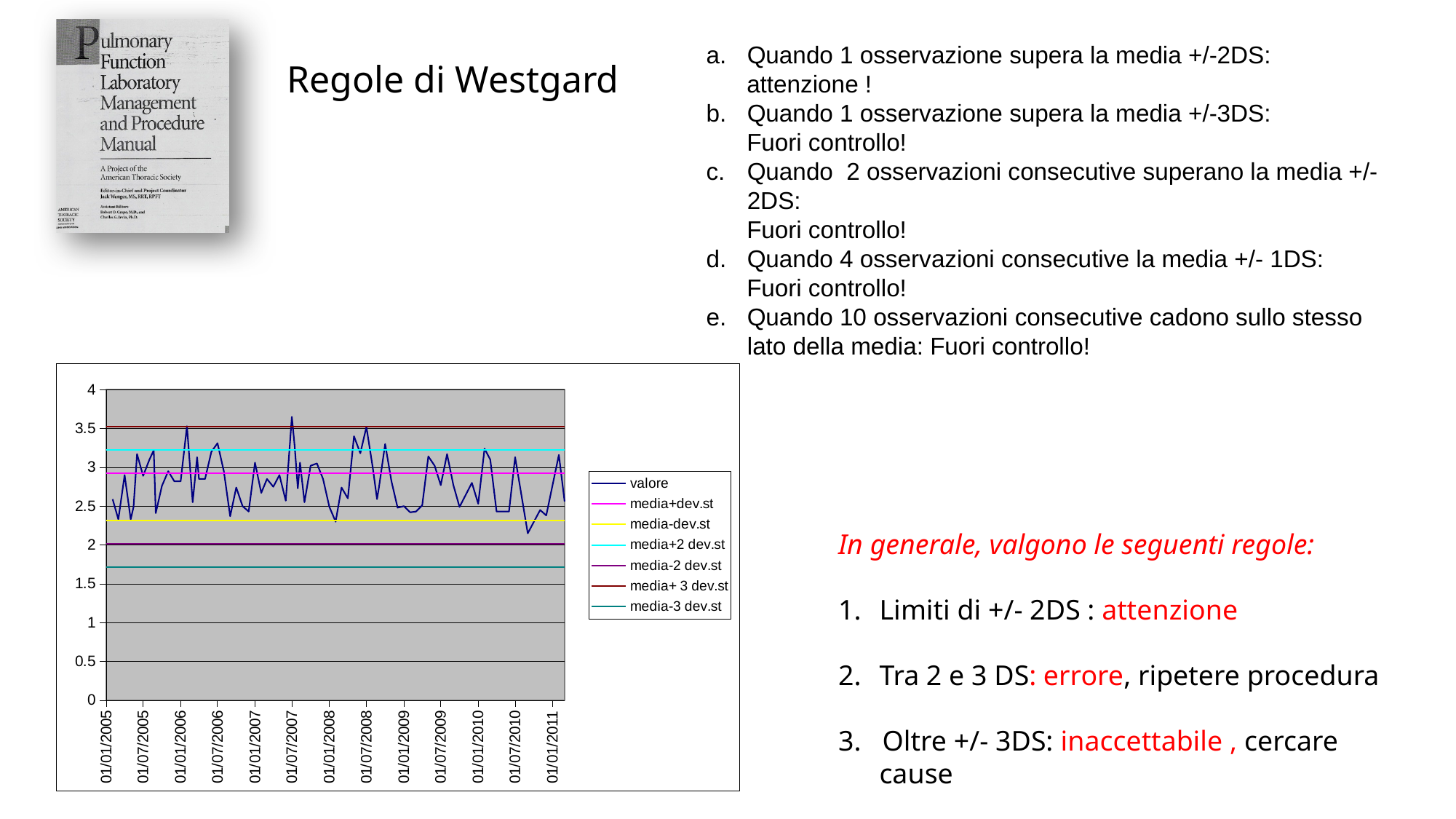
What kind of chart is shown on the slide? line chart How many series does the chart legend list? 7 Which series is drawn as the highest horizontal line on the chart? media+ 3 dev.st Is the value of the media-3 dev.st line greater or less than 2? less Is the value of the media+dev.st line greater or less than 3? less Which series in the legend represents the measured observations rather than a control limit? valore Is the value of the media-dev.st line greater or less than 2.5? less Which is larger, the media+2 dev.st line or the media-2 dev.st line? media+2 dev.st What is the first date label shown on the x axis? 01/01/2005 Which series is drawn as the lowest horizontal line on the chart? media-3 dev.st